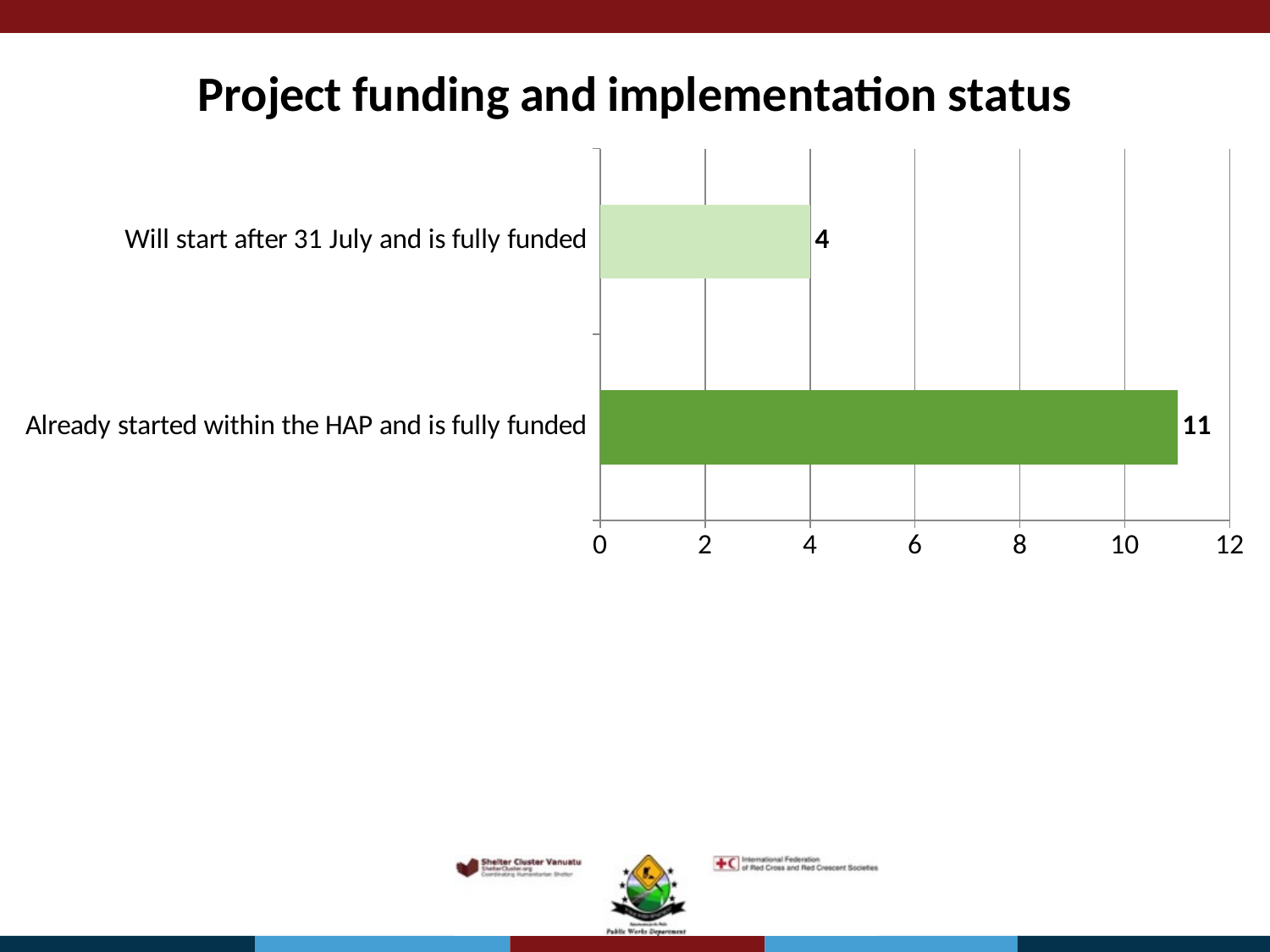
What is the value for 'Already started within the HAP and is fully funded'? 11 How many categories are shown in the chart? 2 What kind of chart is shown on the slide? Bar chart What is the difference between the values for 'Already started within the HAP and is fully funded' and 'Will start after 31 July and is fully funded'? 7 What is the title of the slide containing the chart? Project funding and implementation status Is the value for 'Will start after 31 July and is fully funded' greater or less than 6? less Is the value for 'Already started within the HAP and is fully funded' greater or less than 10? greater Which category has the highest value? Already started within the HAP and is fully funded What is the value for 'Will start after 31 July and is fully funded'? 4 Which category has the lowest value? Will start after 31 July and is fully funded Which is larger: the value for 'Will start after 31 July and is fully funded' or the value for 'Already started within the HAP and is fully funded'? Already started within the HAP and is fully funded What is the maximum value shown on the horizontal axis? 12